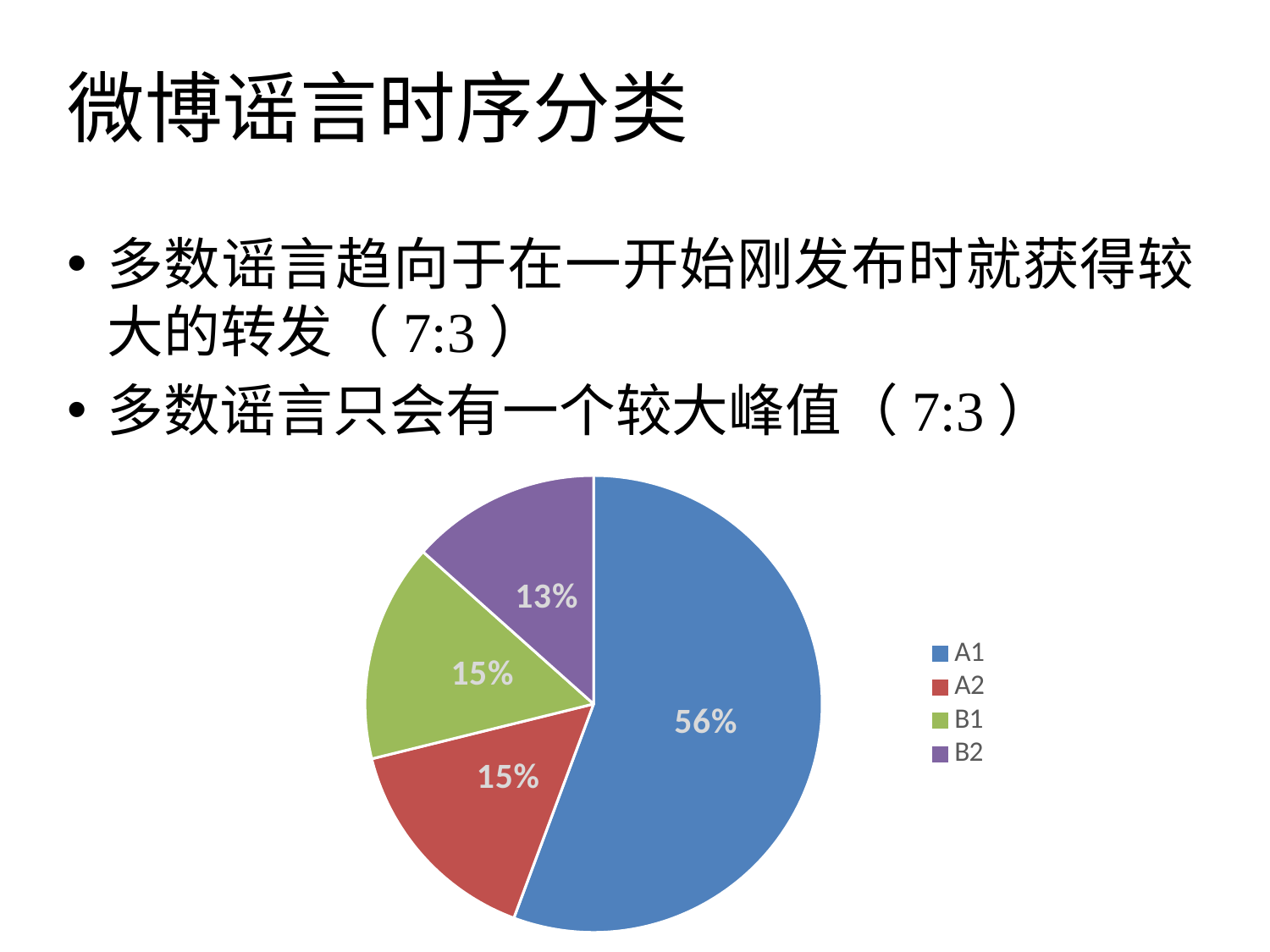
What share of the pie does A1 have? 56% What share of the pie does B2 have? 13% What is the difference in percentage points between A1 and B2? 43 What share of the pie does B1 have? 15% How many categories does the pie chart show? 4 Which is larger, the slice for A1 or the slice for A2? A1 What kind of chart is shown on the slide? pie chart Which category has the largest slice of the pie? A1 Which category has the smallest slice of the pie? B2 What colour is the slice for B1? green Which category does the purple slice represent? B2